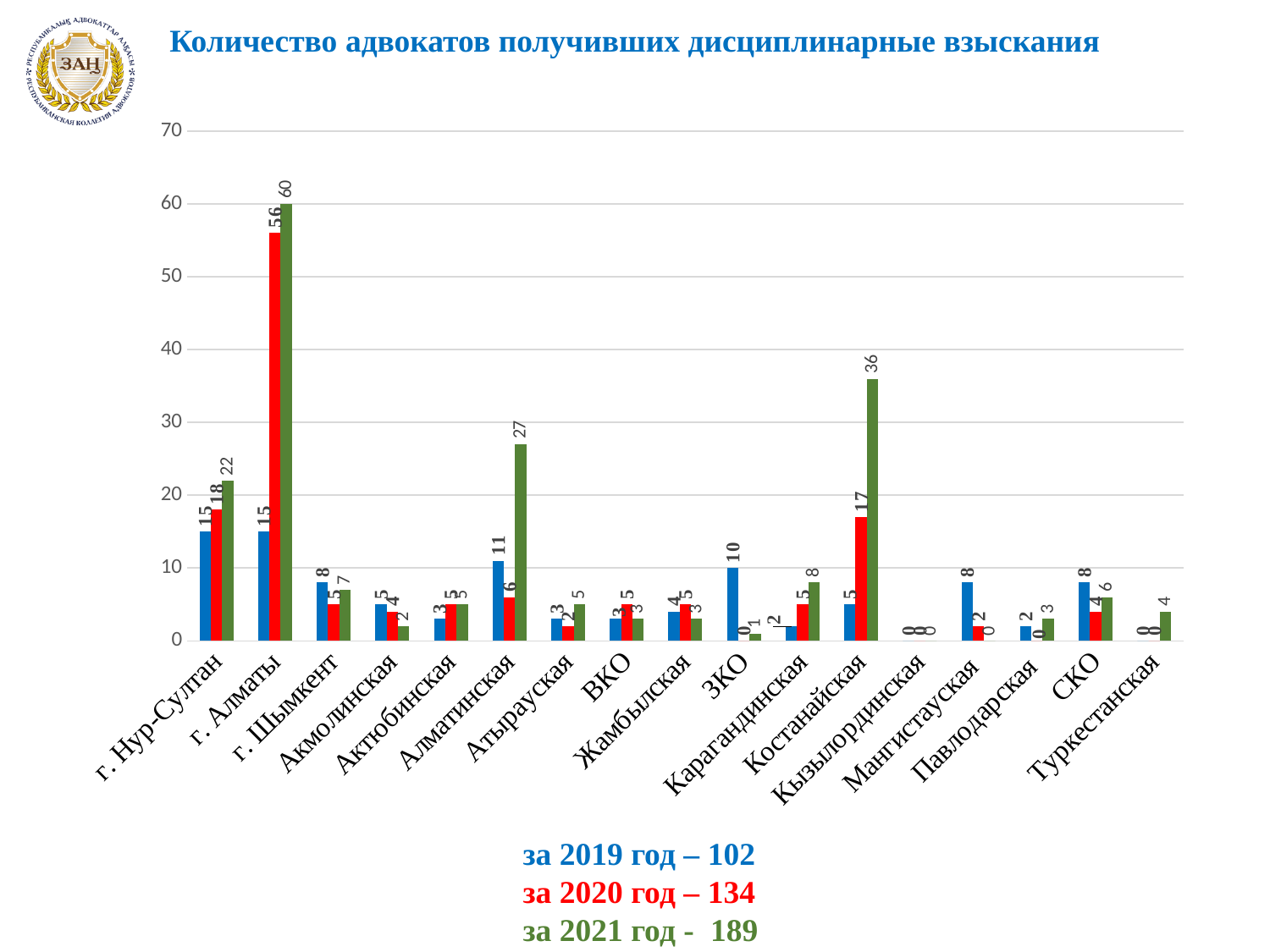
Which is larger for г. Нур-Султан: the blue (2019) bar or the green (2021) bar? green (2021) bar What is the difference between the green (2021) and blue (2019) bars for Костанайская? 31 What is the title of the chart? Количество адвокатов получивших дисциплинарные взыскания What is the value of the red (2020) bar for Костанайская? 17 What is the value of the blue (2019) bar for ЗКО? 10 How many regions (categories) are shown on the x axis? 17 Which region has the highest green (2021) bar? г. Алматы What is the value of the green (2021) bar for Алматинская? 27 What total is given on the slide for 2021 (за 2021 год)? 189 Is the red (2020) bar for г. Алматы greater or less than 50? greater What kind of chart is shown on the slide? bar chart What is the value of the green (2021) bar for г. Алматы? 60